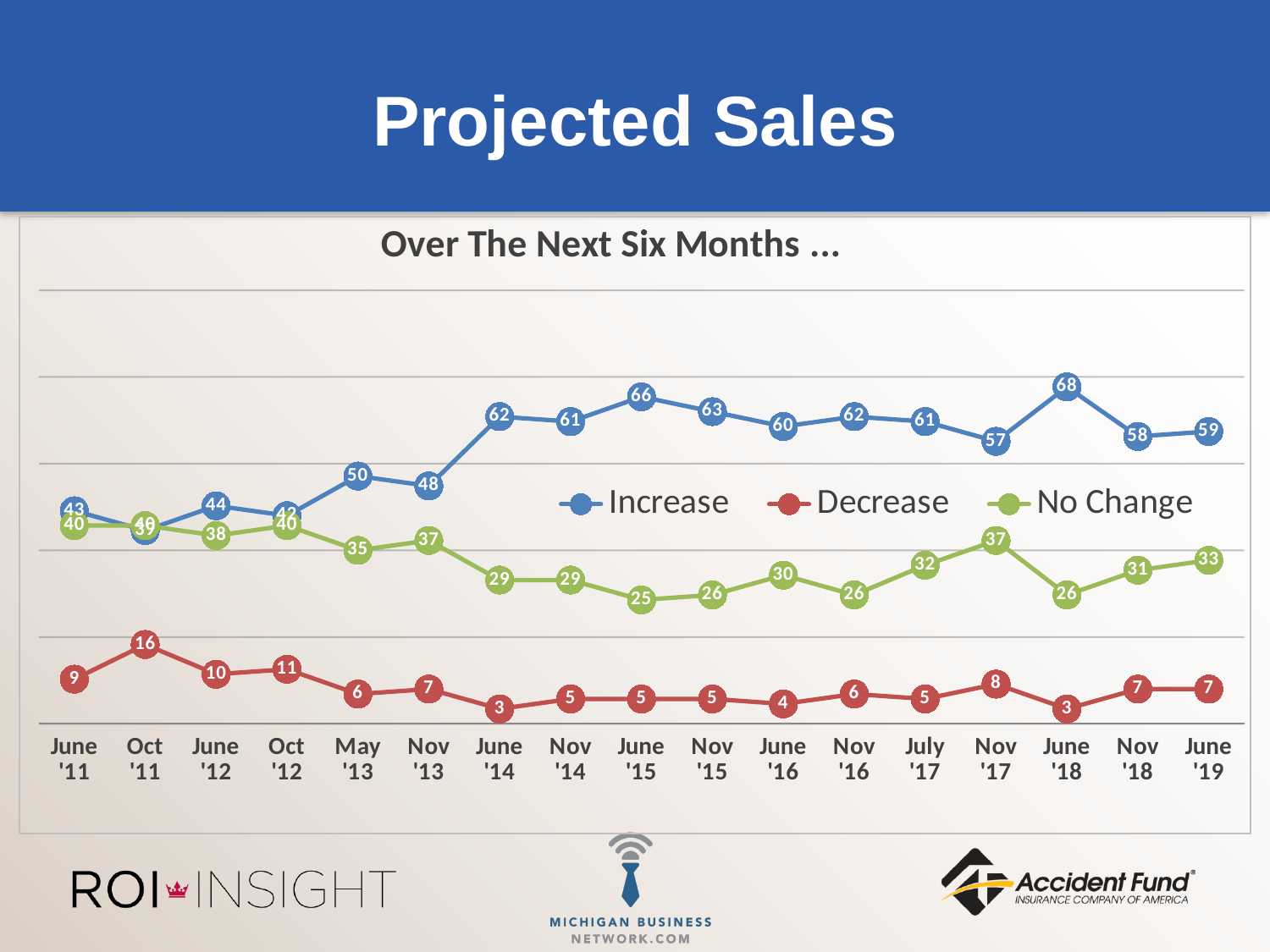
What is the title of the chart? Over The Next Six Months … At which time point is the No Change series lowest? June '15 What is the value of the Increase series in June '18? 68 Which is larger for the No Change series: Nov '17 or June '18? Nov '17 What is the value of the Decrease series in Oct '11? 16 At which time point is the Increase series highest? June '18 How many series does the legend list? 3 What is the difference between the Increase and No Change values in June '19? 26 How many time points are plotted along the x axis? 17 What kind of chart is shown on the slide? line chart Does the Increase series rise or fall from Oct '12 to June '14? rise What is the value of the No Change series in July '17? 32